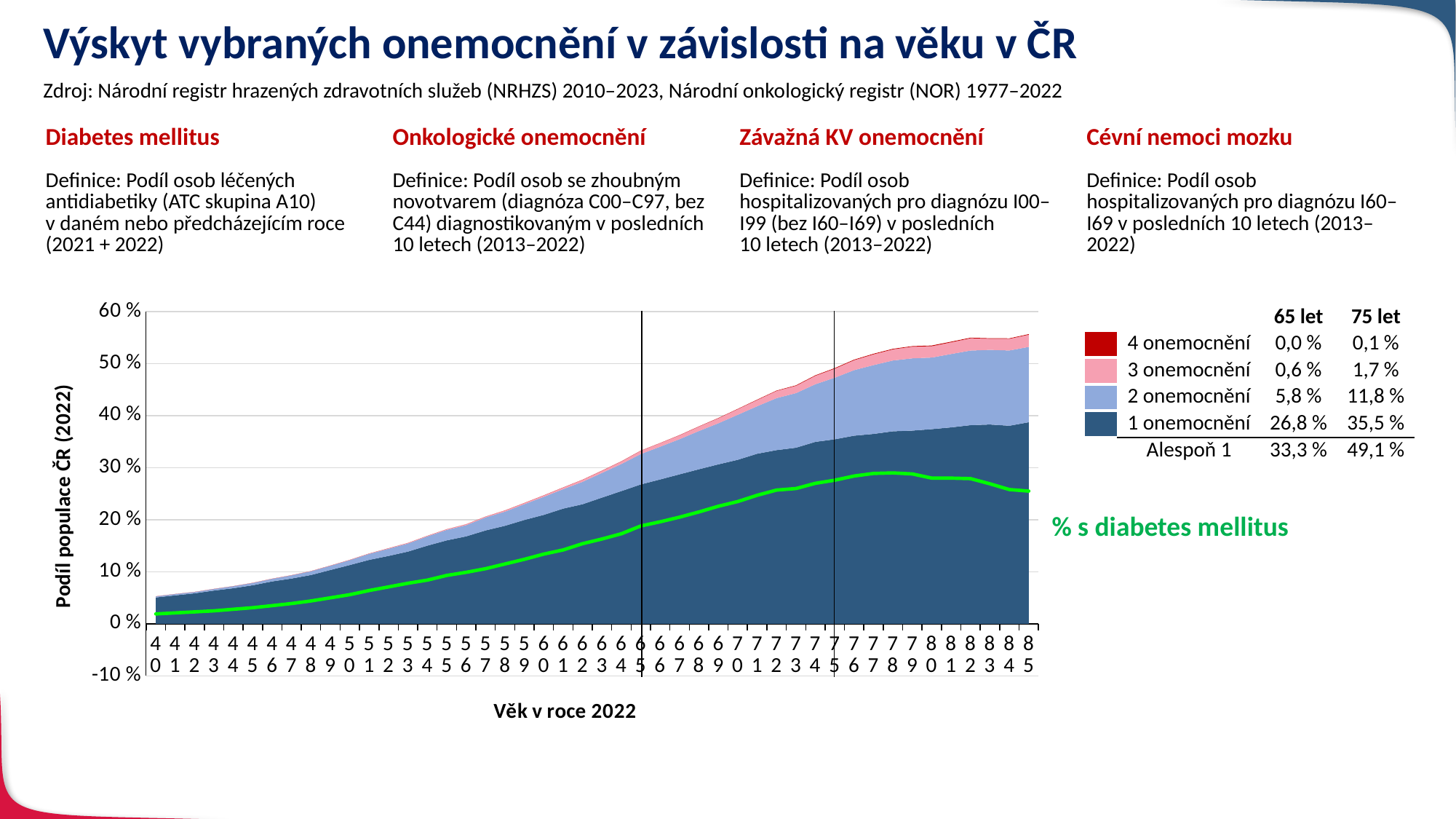
Is the top of the stacked area at age 40 greater or less than 10 %? less In the legend table, which category has the highest value at 75 let? 1 onemocnění In the legend table, which is larger: "2 onemocnění" at 75 let or "1 onemocnění" at 65 let? 1 onemocnění at 65 let What is the title of the x axis? Věk v roce 2022 What is the difference between the "1 onemocnění" values at 75 let and 65 let in the legend table? 8,7 % How many entries does the chart legend list? 4 According to the legend table, what is the value for "Alespoň 1" at 75 let? 49,1 % What is the difference between the "Alespoň 1" values at 75 let and 65 let in the legend table? 15,8 % Is the value of the green "% s diabetes mellitus" line at age 85 greater or less than 20 %? greater According to the legend table, what is the value for "2 onemocnění" at 75 let? 11,8 % According to the legend table, what is the value for "1 onemocnění" at 65 let? 26,8 % What kind of chart is shown on the slide? Stacked area chart with a line